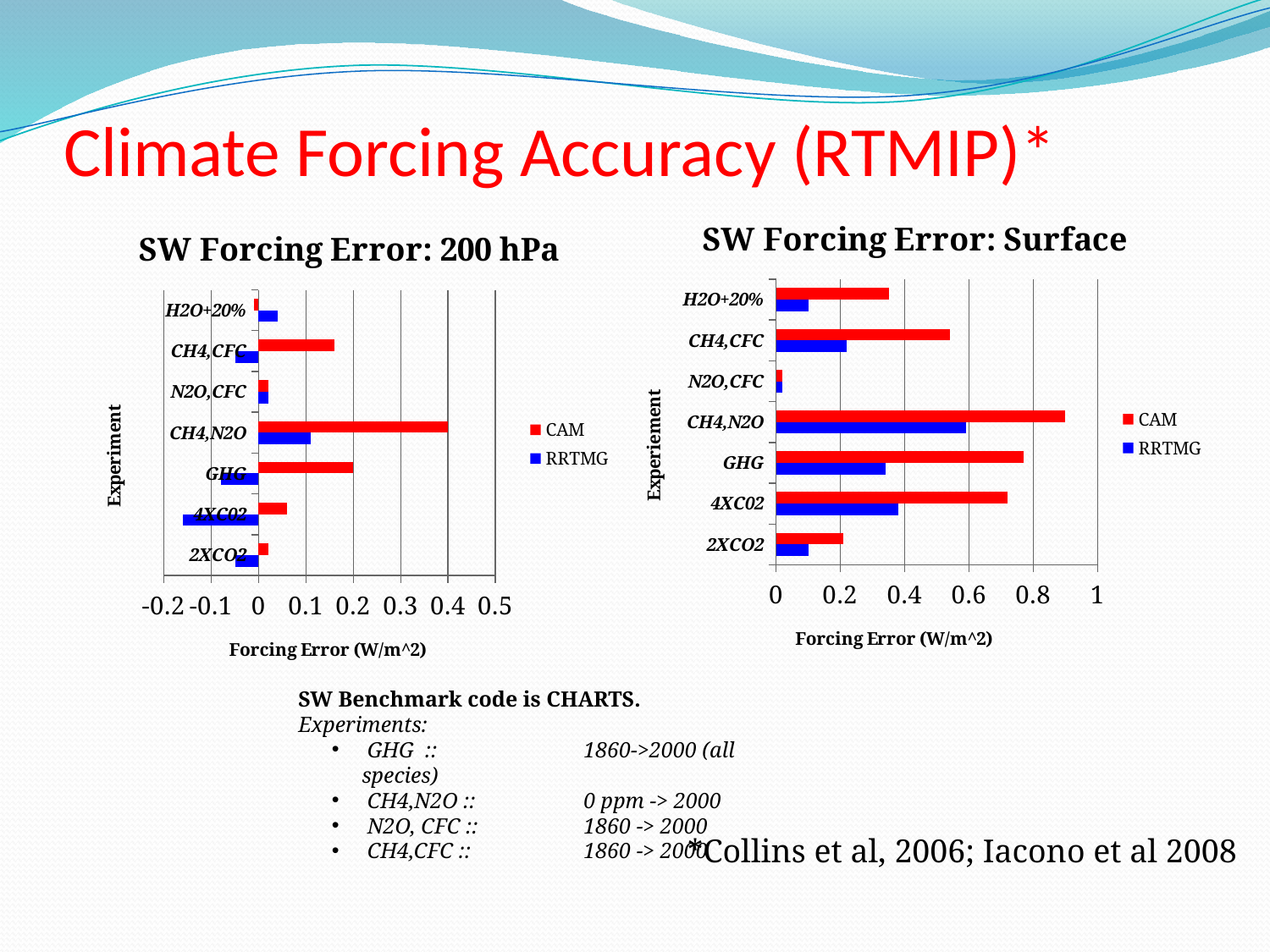
How many series does the legend of the "SW Forcing Error: 200 hPa" chart list? 2 In the "SW Forcing Error: Surface" chart, which experiment has the lowest CAM forcing error? N2O,CFC In the "SW Forcing Error: Surface" chart, which series has the larger value for CH4,CFC, CAM or RRTMG? CAM How many experiment categories are shown on the "SW Forcing Error: Surface" chart? 7 In the "SW Forcing Error: 200 hPa" chart, is the CAM value for CH4,N2O greater or less than 0.3? greater What kind of chart is the "SW Forcing Error: Surface" chart? bar chart In the "SW Forcing Error: 200 hPa" chart, which experiment has the highest CAM forcing error? CH4,N2O In the "SW Forcing Error: Surface" chart, is the RRTMG value for CH4,N2O greater or less than 0.4? greater In the "SW Forcing Error: 200 hPa" chart, is the RRTMG value for 4XC02 greater or less than 0? less What is the x-axis title of the "SW Forcing Error: Surface" chart? Forcing Error (W/m^2) In the "SW Forcing Error: Surface" chart, which experiment has the highest CAM forcing error? CH4,N2O